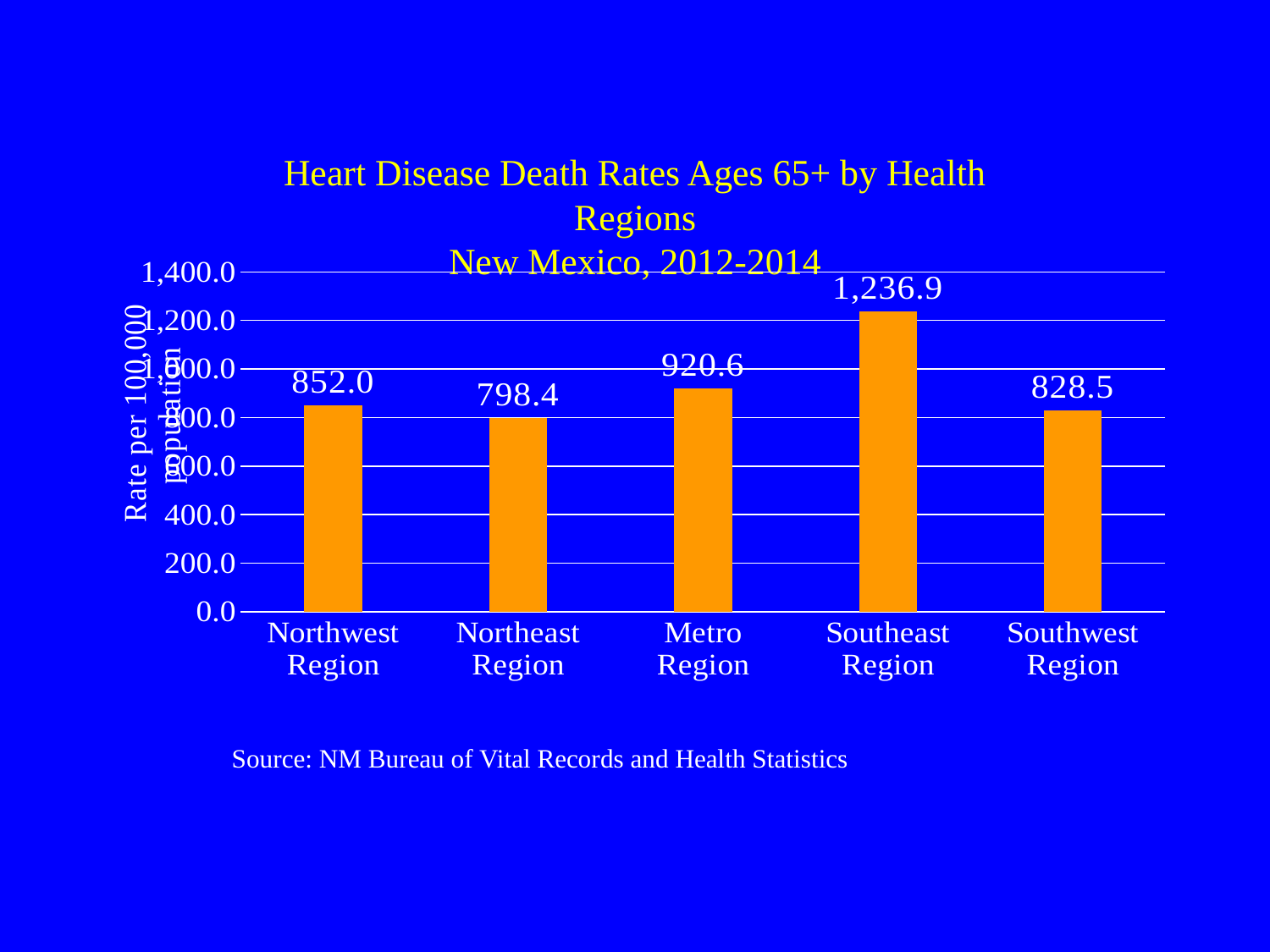
What is the source cited below the chart? NM Bureau of Vital Records and Health Statistics What is the value shown for the Metro Region? 920.6 What kind of chart is shown on the slide? Bar chart Which has a higher rate, the Metro Region or the Northwest Region? Metro Region How many regions are shown on the chart? 5 What is the heart disease death rate for the Northeast Region? 798.4 What is the heart disease death rate for the Southeast Region? 1,236.9 Is the value for the Southeast Region greater or less than 1,200.0? greater What is the difference between the Northwest Region and Southwest Region rates? 23.5 Which region has the lowest heart disease death rate? Northeast Region Which region has the highest heart disease death rate? Southeast Region What is the difference between the Southeast Region and the Northeast Region rates? 438.5